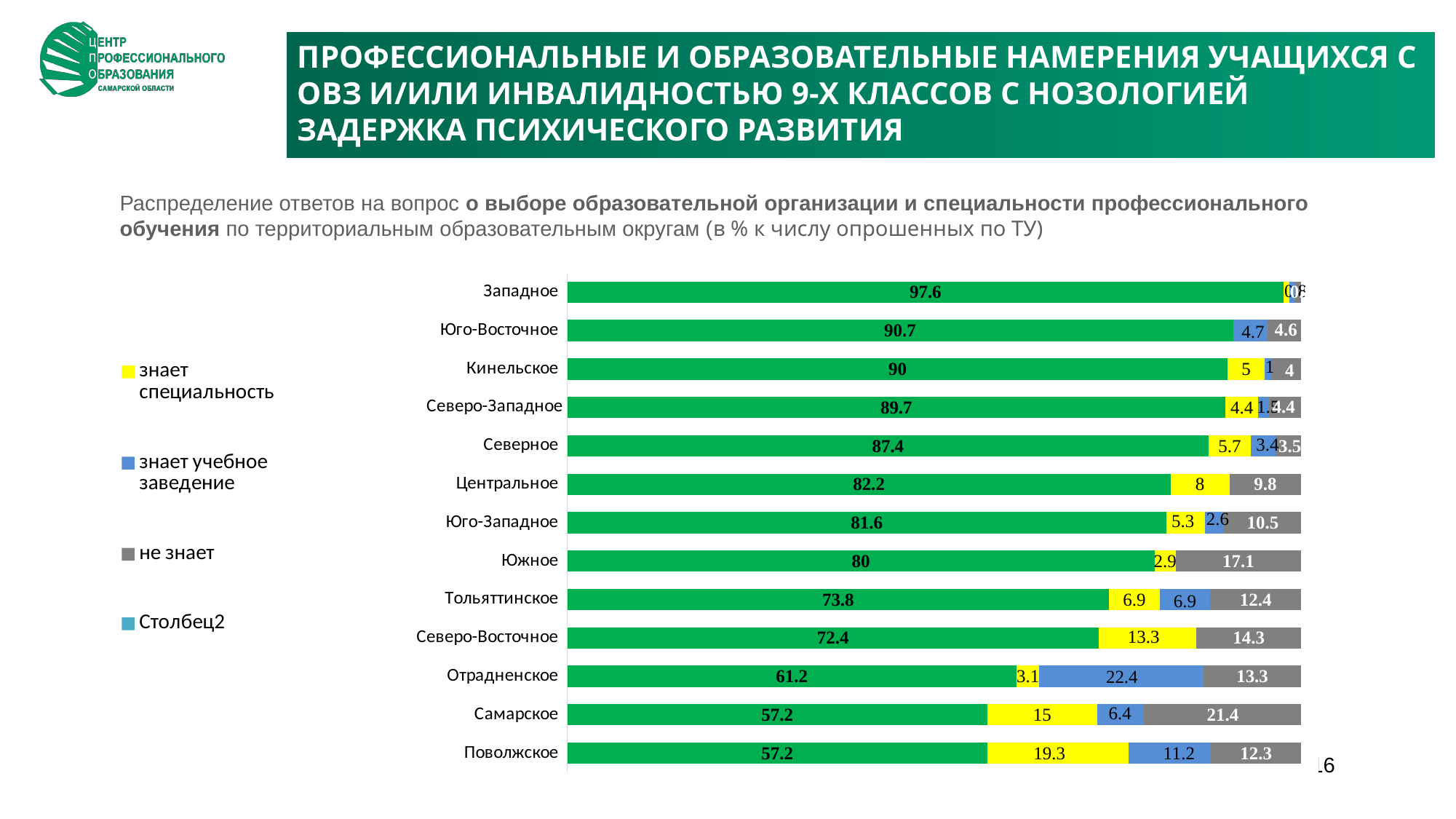
Which district has the largest 'не знает' (grey) value? Самарское What is the value of the 'знает специальность' (yellow) segment for Поволжское? 19.3 How many series does the legend list? 4 What is the difference between the green segment values for Центральное and Южное? 2.2 Which is larger: the blue segment for Отрадненское or the blue segment for Поволжское? Отрадненское How many districts are shown on the chart? 13 What colour does the legend use for 'не знает'? Grey What kind of chart is shown on the slide? Stacked bar chart What is the value of the 'не знает' (grey) segment for Самарское? 21.4 Which district has the largest green segment value? Западное What is the value of the 'знает учебное заведение' (blue) segment for Отрадненское? 22.4 What is the value of the green segment for Западное? 97.6